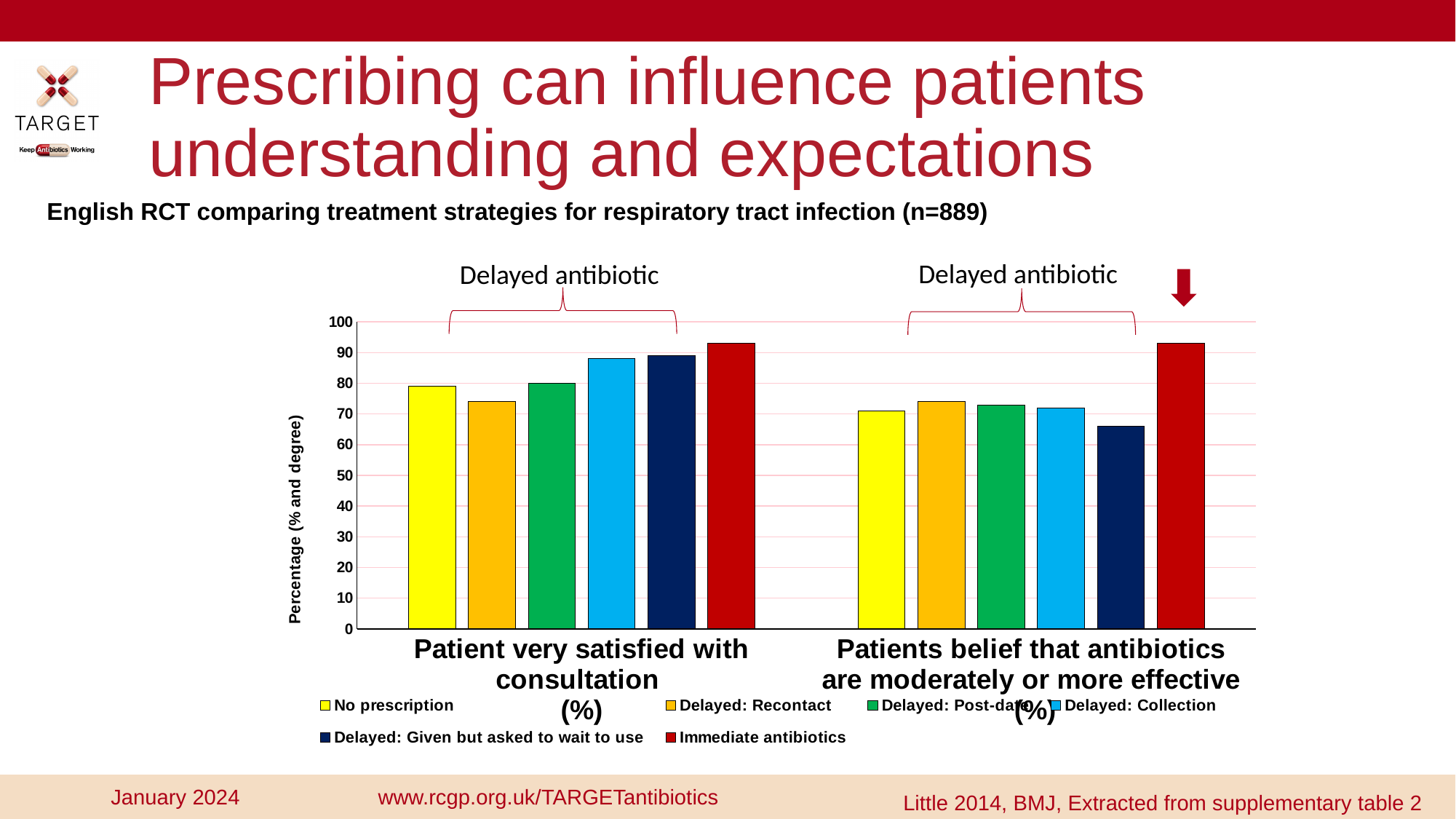
How many categories are shown on the x axis? 2 Is the value for Delayed: Collection in 'Patient very satisfied with consultation (%)' greater or less than 80? greater For Delayed: Collection, which category has the larger value: 'Patient very satisfied with consultation (%)' or 'Patients belief that antibiotics are moderately or more effective (%)'? Patient very satisfied with consultation (%) Is the value for Delayed: Recontact in 'Patients belief that antibiotics are moderately or more effective (%)' greater or less than 80? less Which series has the lowest value for 'Patient very satisfied with consultation (%)'? Delayed: Recontact What kind of chart is shown on the slide? Bar chart What is the title of the y axis? Percentage (% and degree) Is the value for Delayed: Given but asked to wait to use in 'Patients belief that antibiotics are moderately or more effective (%)' greater or less than 70? less Which series has the lowest value for 'Patients belief that antibiotics are moderately or more effective (%)'? Delayed: Given but asked to wait to use How many series does the legend list? 6 Which series has the highest value for 'Patients belief that antibiotics are moderately or more effective (%)'? Immediate antibiotics